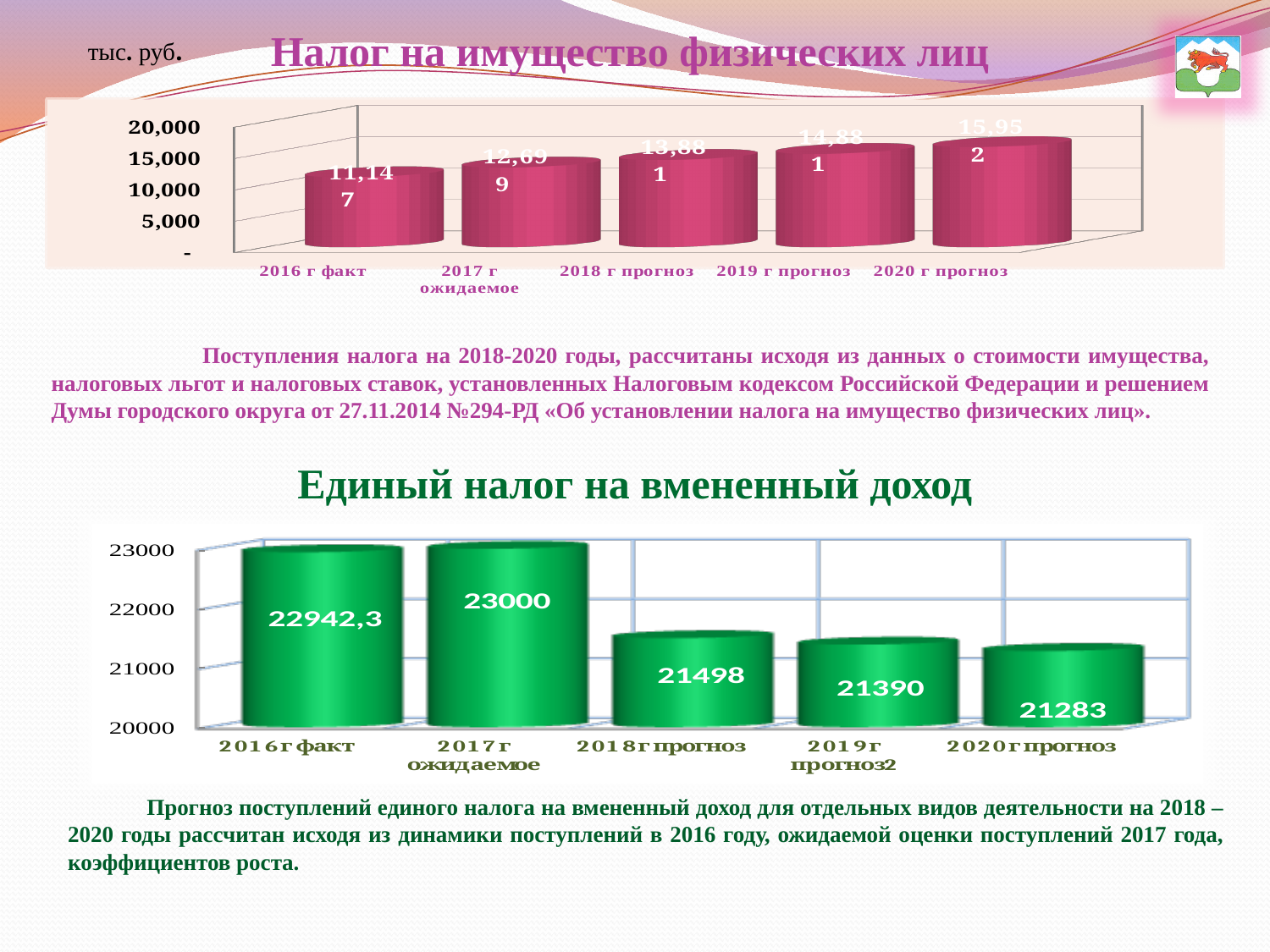
On the chart 'Единый налог на вмененный доход', which category has the highest value? 2017 г ожидаемое On the chart 'Налог на имущество физических лиц', is the value for '2016 г факт' greater or less than 15,000? less On the chart 'Налог на имущество физических лиц', do the values rise or fall from 2016 to 2020? rise On the chart 'Единый налог на вмененный доход', what is the value for '2020 г прогноз'? 21283 On the chart 'Единый налог на вмененный доход', which category has the lowest value? 2020 г прогноз On the chart 'Единый налог на вмененный доход', which is larger: the value for '2018 г прогноз' or '2020 г прогноз'? 2018 г прогноз On the chart 'Единый налог на вмененный доход', how many categories are shown? 5 On the chart 'Налог на имущество физических лиц', which category has the highest value? 2020 г прогноз What kind of chart is 'Налог на имущество физических лиц'? bar chart On the chart 'Единый налог на вмененный доход', what is the value for '2016 г факт'? 22942,3 On the chart 'Единый налог на вмененный доход', what is the value for '2017 г ожидаемое'? 23000 On the chart 'Единый налог на вмененный доход', what is the difference between the values for '2018 г прогноз' and '2019 г прогноз2'? 108